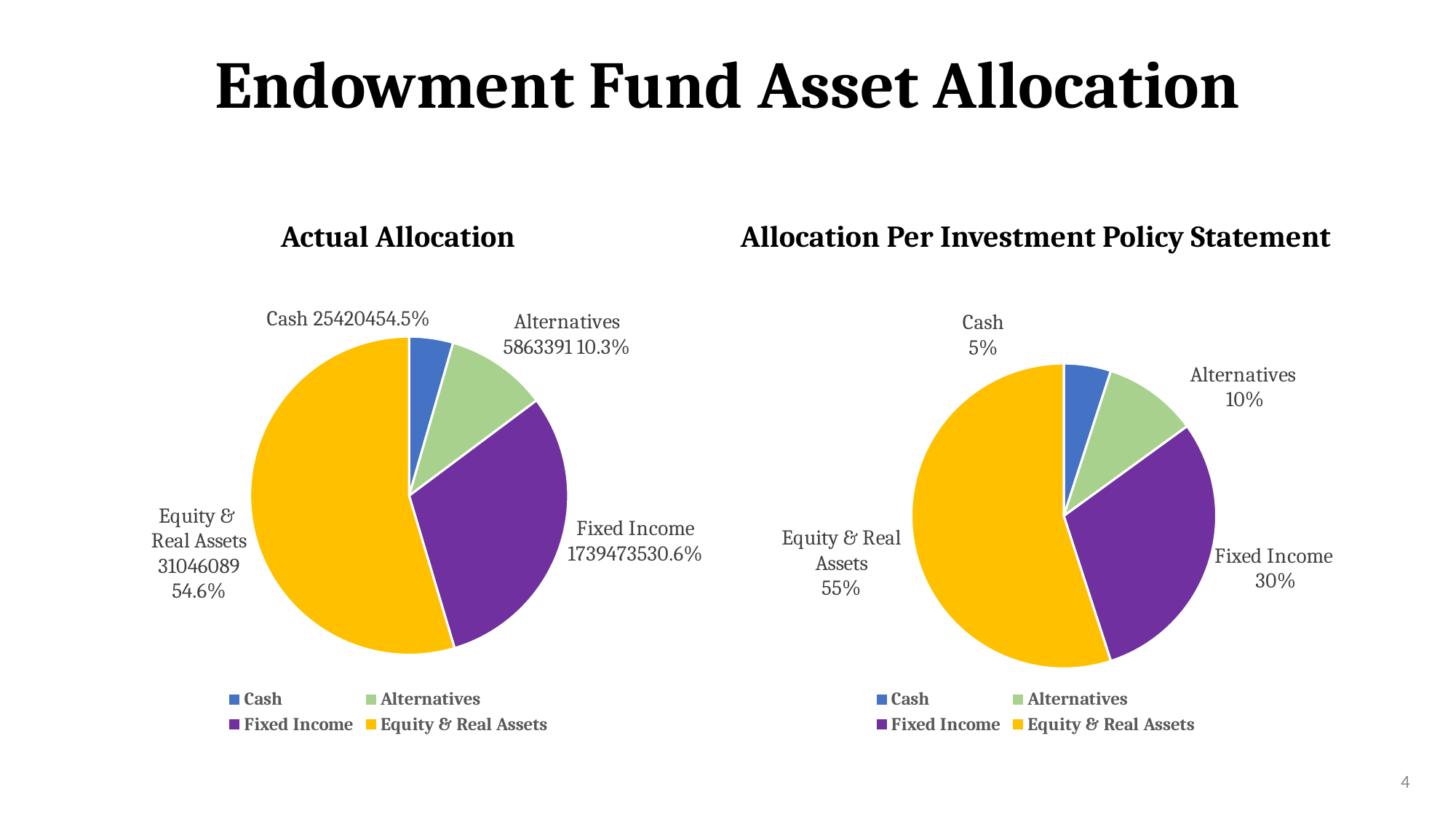
In the Actual Allocation chart, which is larger: the Fixed Income share or the Alternatives share? Fixed Income In the Actual Allocation chart, which category has the smallest slice? Cash In the Allocation Per Investment Policy Statement chart, what share is allocated to Fixed Income? 30% In the Actual Allocation chart, what percentage share does Equity & Real Assets have? 54.6% How many categories does the legend of the Allocation Per Investment Policy Statement chart list? 4 In the Actual Allocation chart, what percentage share does Alternatives have? 10.3% What kind of chart is the Actual Allocation chart? pie chart What colour represents Fixed Income in both pie charts? purple In the Actual Allocation chart, what is the value shown for Equity & Real Assets? 31046089 In the Allocation Per Investment Policy Statement chart, what is the difference between the Equity & Real Assets share and the Fixed Income share? 25% In the Allocation Per Investment Policy Statement chart, what share is allocated to Cash? 5% In the Allocation Per Investment Policy Statement chart, which category has the largest slice? Equity & Real Assets